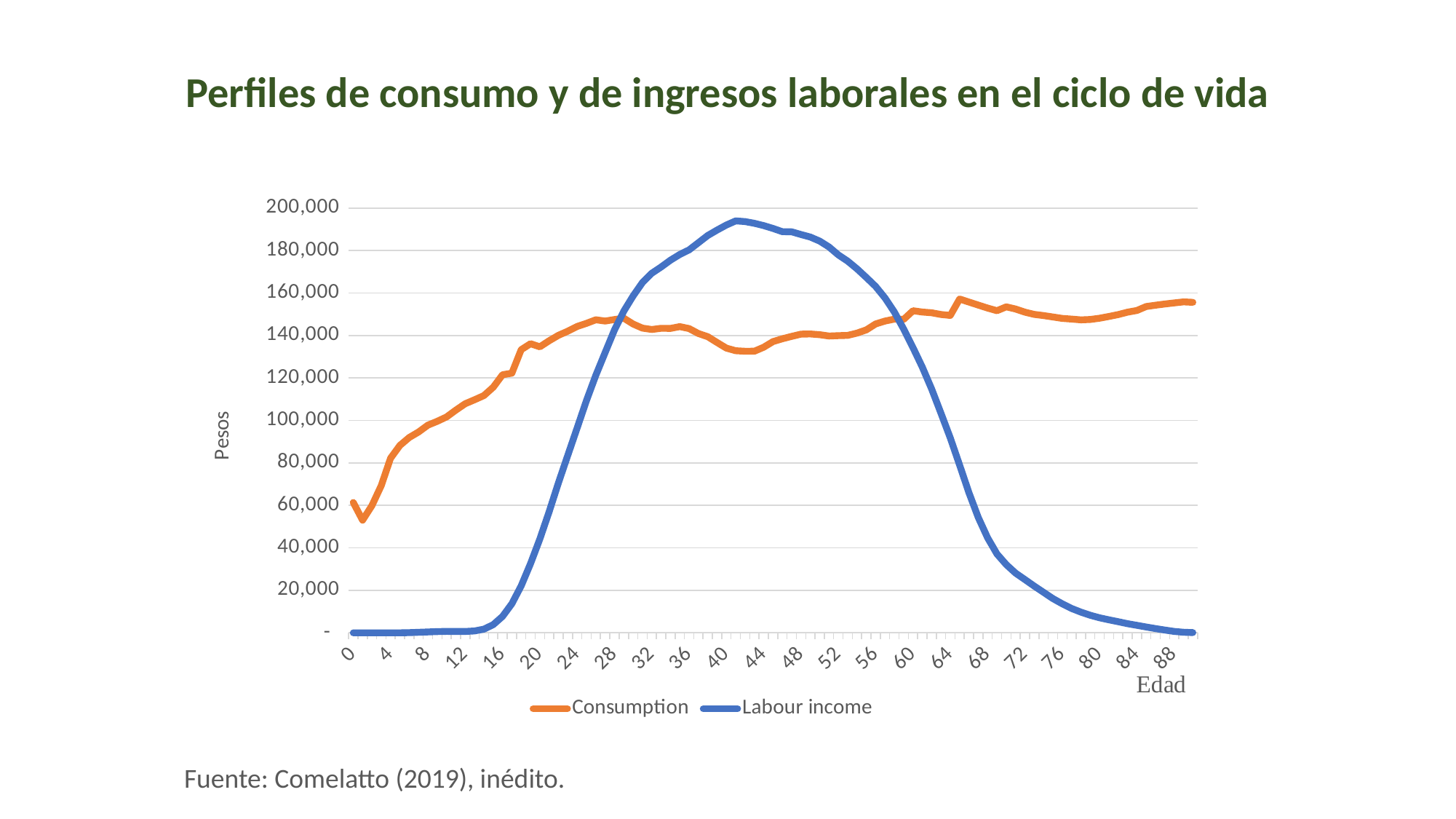
What is the label on the vertical axis? Pesos How many series does the legend list? 2 Does Labour income rise or fall between age 60 and age 88? Fall Is the value of Consumption at age 88 greater or less than 140,000? greater At age 80, which series has the larger value, Consumption or Labour income? Consumption Is the value of Consumption at age 0 greater or less than 80,000? less What are the two series named in the legend? Consumption and Labour income Is the value of Labour income at age 40 greater or less than 180,000? greater What kind of chart is shown on the slide? Line chart At age 40, which series has the larger value, Consumption or Labour income? Labour income Does Consumption rise or fall between age 4 and age 28? Rise